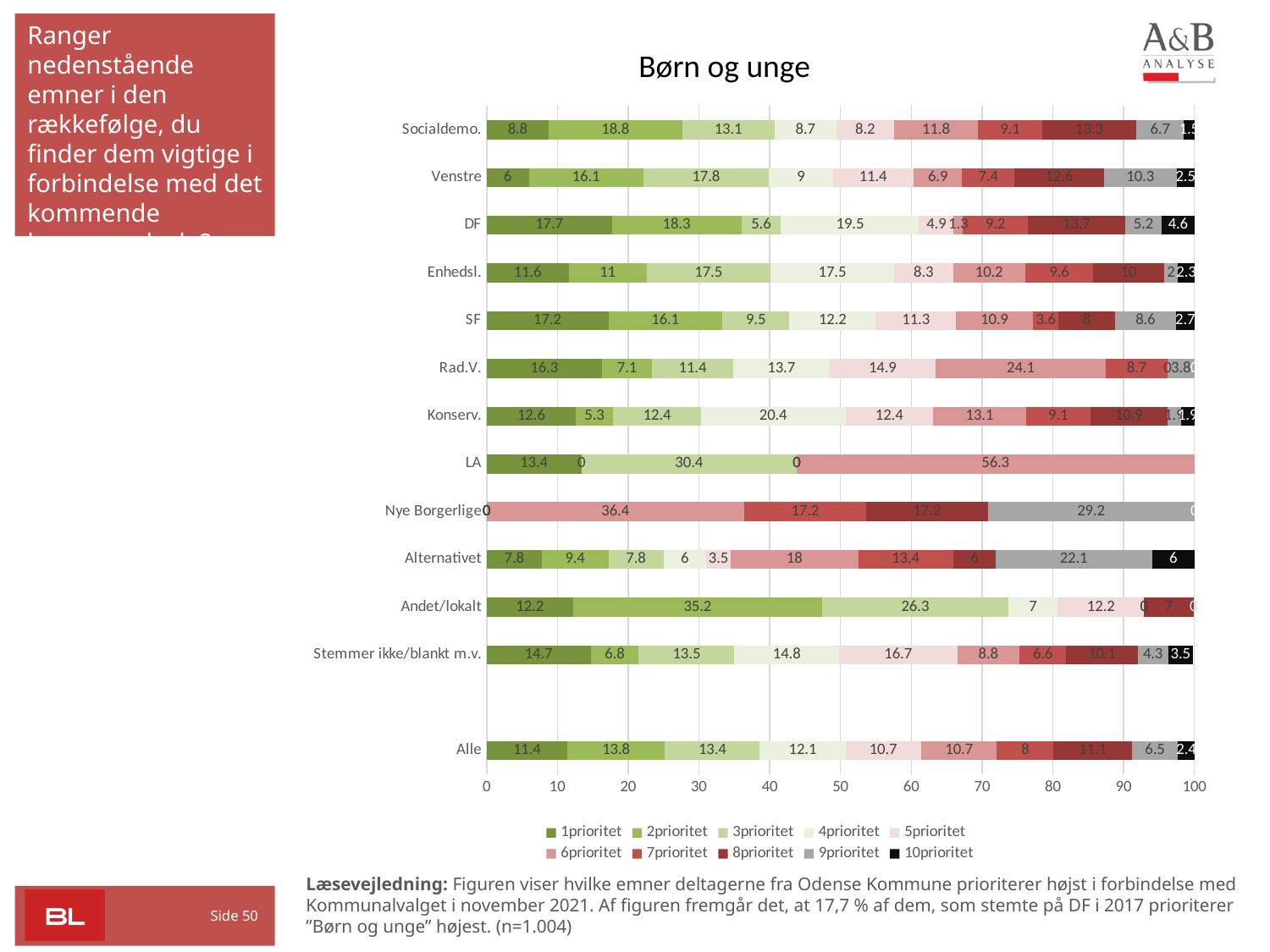
What is the difference between the 1prioritet values for SF and Venstre? 11.2 Which category has the highest 1prioritet value? DF Which is larger, the 2prioritet value for Socialdemo. or for Enhedsl.? Socialdemo. What is the 6prioritet value for LA? 56.3 What is the 2prioritet value for Andet/lokalt? 35.2 What kind of chart is shown on the slide? Stacked bar chart How many categories (bars) are shown on the y axis? 13 What is the 1prioritet value for DF? 17.7 How many series does the legend list? 10 Which category has the lowest 1prioritet value? Nye Borgerlige What is the 1prioritet value for Alle? 11.4 What is the title of the chart? Børn og unge